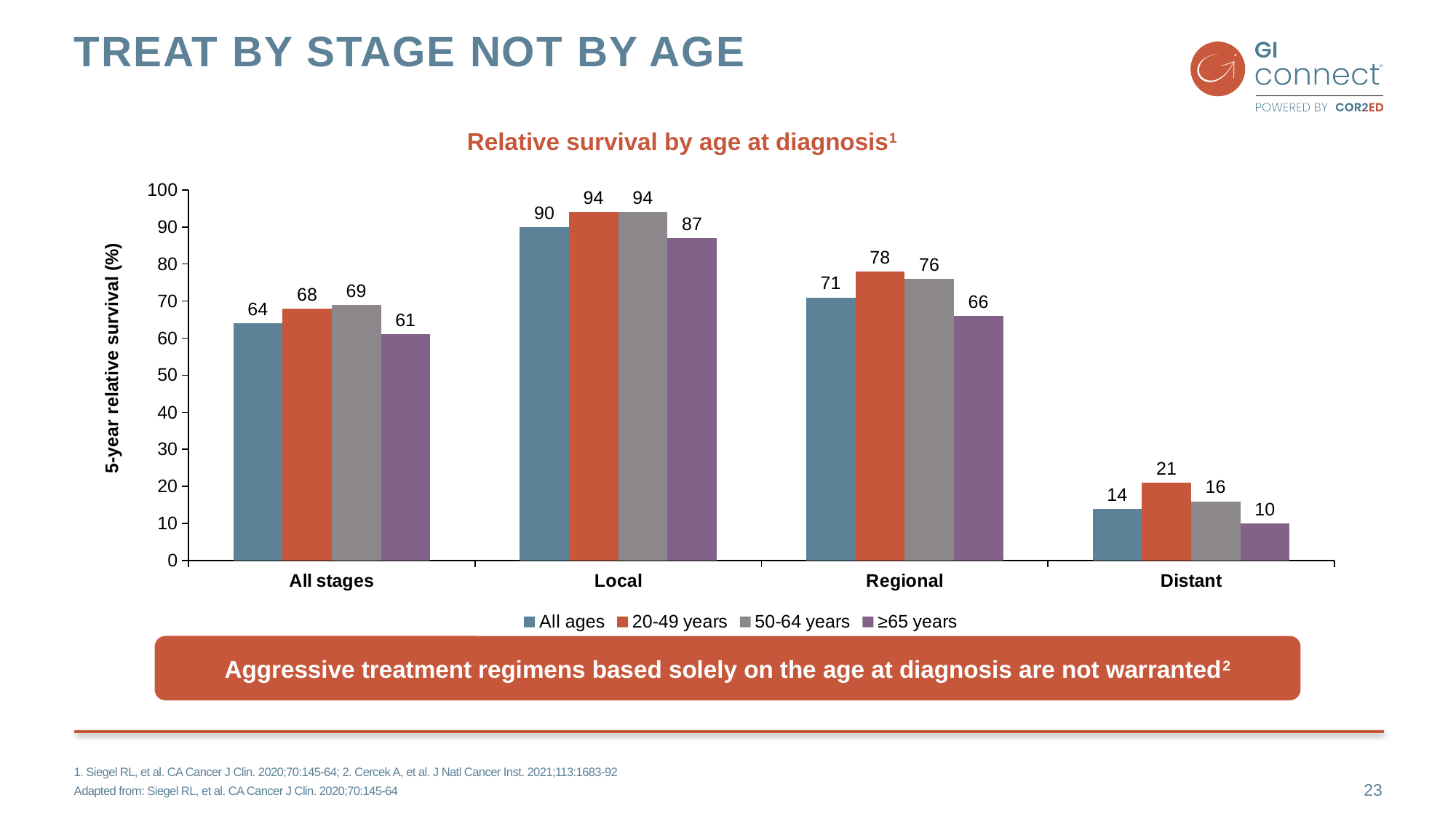
What is the label of the y axis? 5-year relative survival (%) What is the difference between the 20-49 years and ≥65 years values in the Regional category? 12 Which age group has the highest 5-year relative survival in the Regional category? 20-49 years What is the 5-year relative survival for the 20-49 years group at the Local stage? 94 What is the 5-year relative survival for the ≥65 years group at the Distant stage? 10 Is the value for 50-64 years at the Local stage larger than the value for ≥65 years at the Local stage? Yes What kind of chart is shown on the slide? Bar chart How many stage categories are shown on the x axis? 4 How many series does the legend list? 4 Which stage category has the lowest 5-year relative survival for the ≥65 years group? Distant What is the value for All ages in the Regional category? 71 What is the title of the chart? Relative survival by age at diagnosis